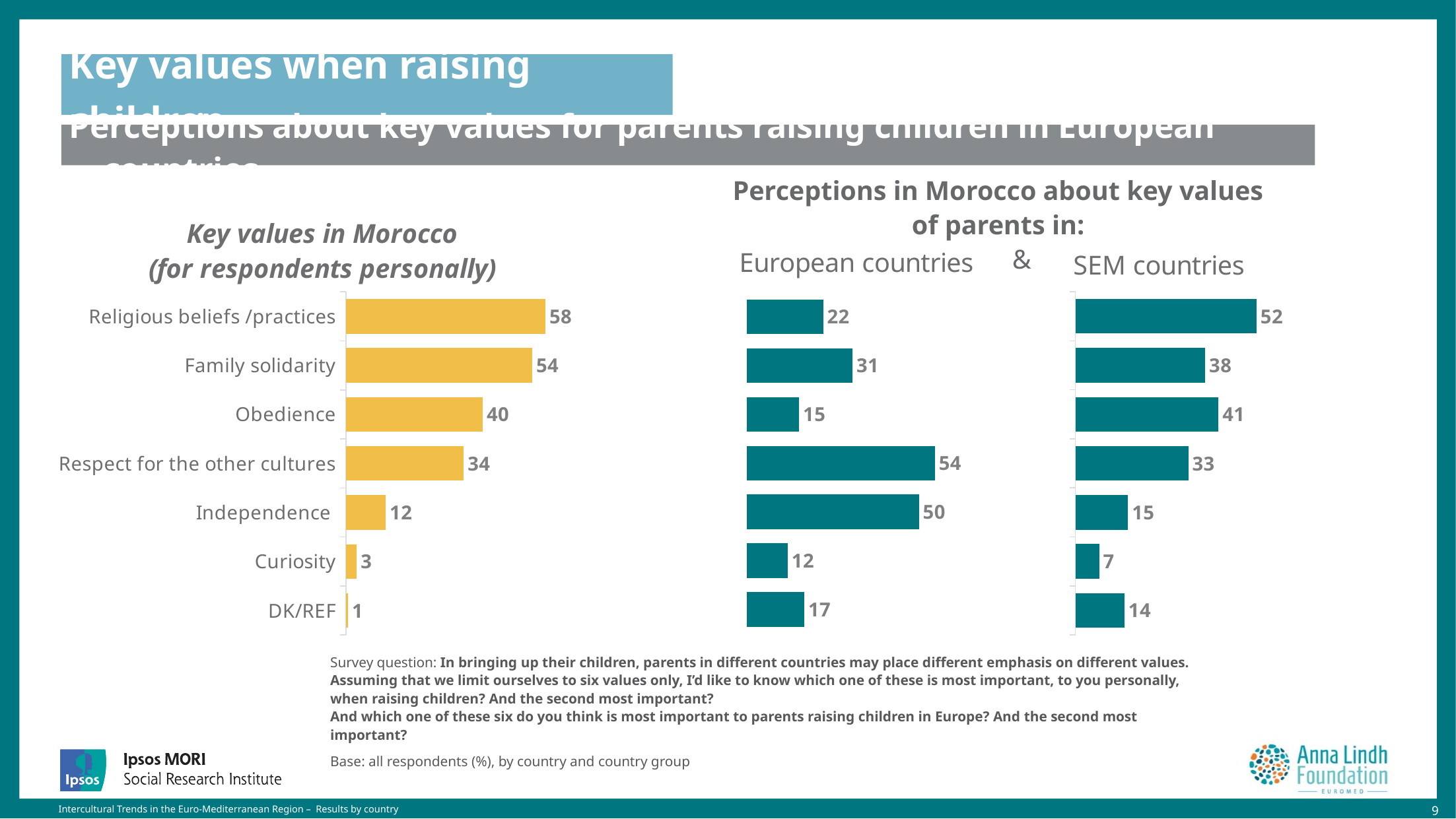
In the 'SEM countries' chart, what is the value for Obedience? 41 In the 'Key values in Morocco (for respondents personally)' chart, which category has the lowest value? DK/REF What type of chart is the 'Key values in Morocco (for respondents personally)' chart? Bar chart What is the difference between the value for Religious beliefs /practices in the 'SEM countries' chart and in the 'European countries' chart? 30 In the 'European countries' chart, what is the value for Respect for the other cultures? 54 Which is larger: the value for Independence in the 'European countries' chart or in the 'SEM countries' chart? European countries In the 'European countries' chart, which category has the lowest value? Curiosity How many categories are shown in the 'Key values in Morocco (for respondents personally)' chart? 7 In the 'SEM countries' chart, which category has the highest value? Religious beliefs /practices In the 'Key values in Morocco (for respondents personally)' chart, what is the value for Family solidarity? 54 In the 'Key values in Morocco (for respondents personally)' chart, which category has the highest value? Religious beliefs /practices In the 'Key values in Morocco (for respondents personally)' chart, what is the difference between Obedience and Independence? 28